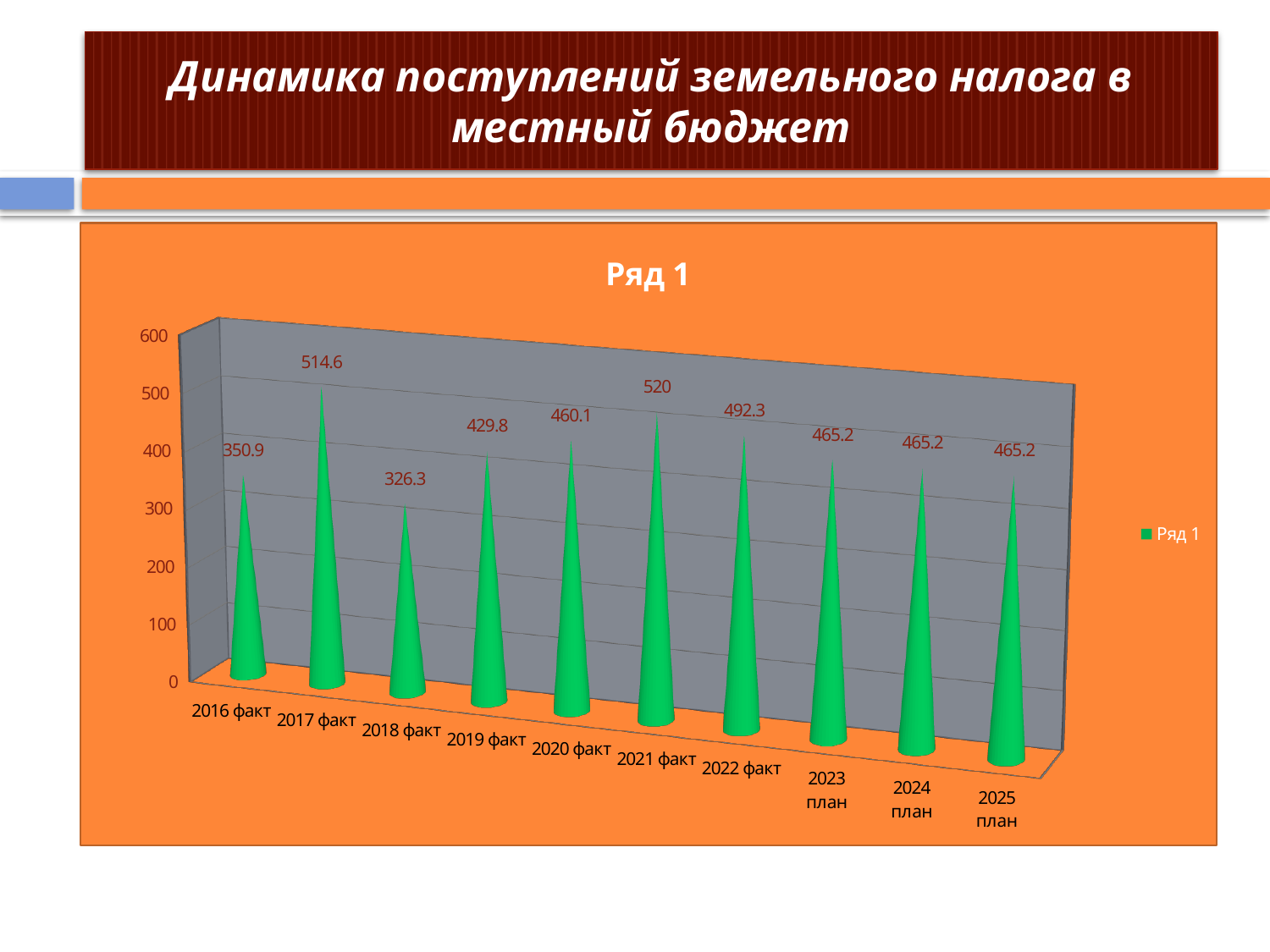
What is the value for 2016 факт? 350.9 Which is larger, the value for 2019 факт or the value for 2020 факт? 2020 факт How many categories are shown on the x axis? 10 What is the value for 2017 факт? 514.6 Which category has the lowest value? 2018 факт How many series does the legend list? 1 What is the title shown above the chart? Ряд 1 What is the value for 2021 факт? 520 What is the difference between the values for 2021 факт and 2022 факт? 27.7 What is the difference between the values for 2017 факт and 2016 факт? 163.7 Which category has the highest value? 2021 факт What is the value for 2025 план? 465.2